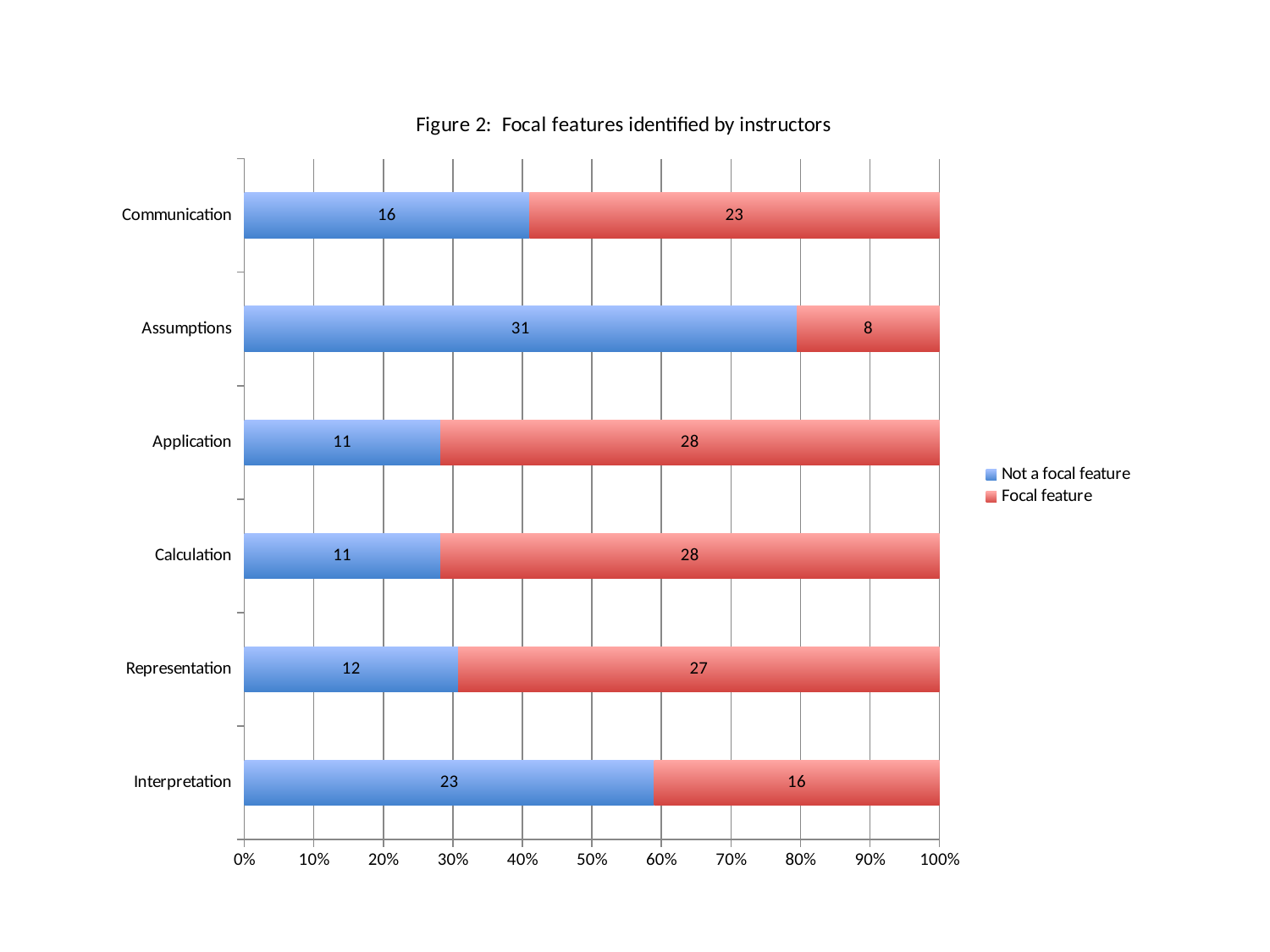
Which category has the highest 'Not a focal feature' value? Assumptions What is the 'Focal feature' value for Interpretation? 16 What is the 'Focal feature' value for Application? 28 How many series does the legend list? 2 What is the title of the chart? Figure 2: Focal features identified by instructors How many categories are shown on the chart? 6 Which category has the highest 'Focal feature' value? Application and Calculation What kind of chart is shown? Stacked bar chart What is the 'Not a focal feature' value for Assumptions? 31 What is the difference between the 'Focal feature' values for Communication and Assumptions? 15 Which category has the lowest 'Focal feature' value? Assumptions Which is larger: the 'Not a focal feature' value for Interpretation or for Communication? Interpretation